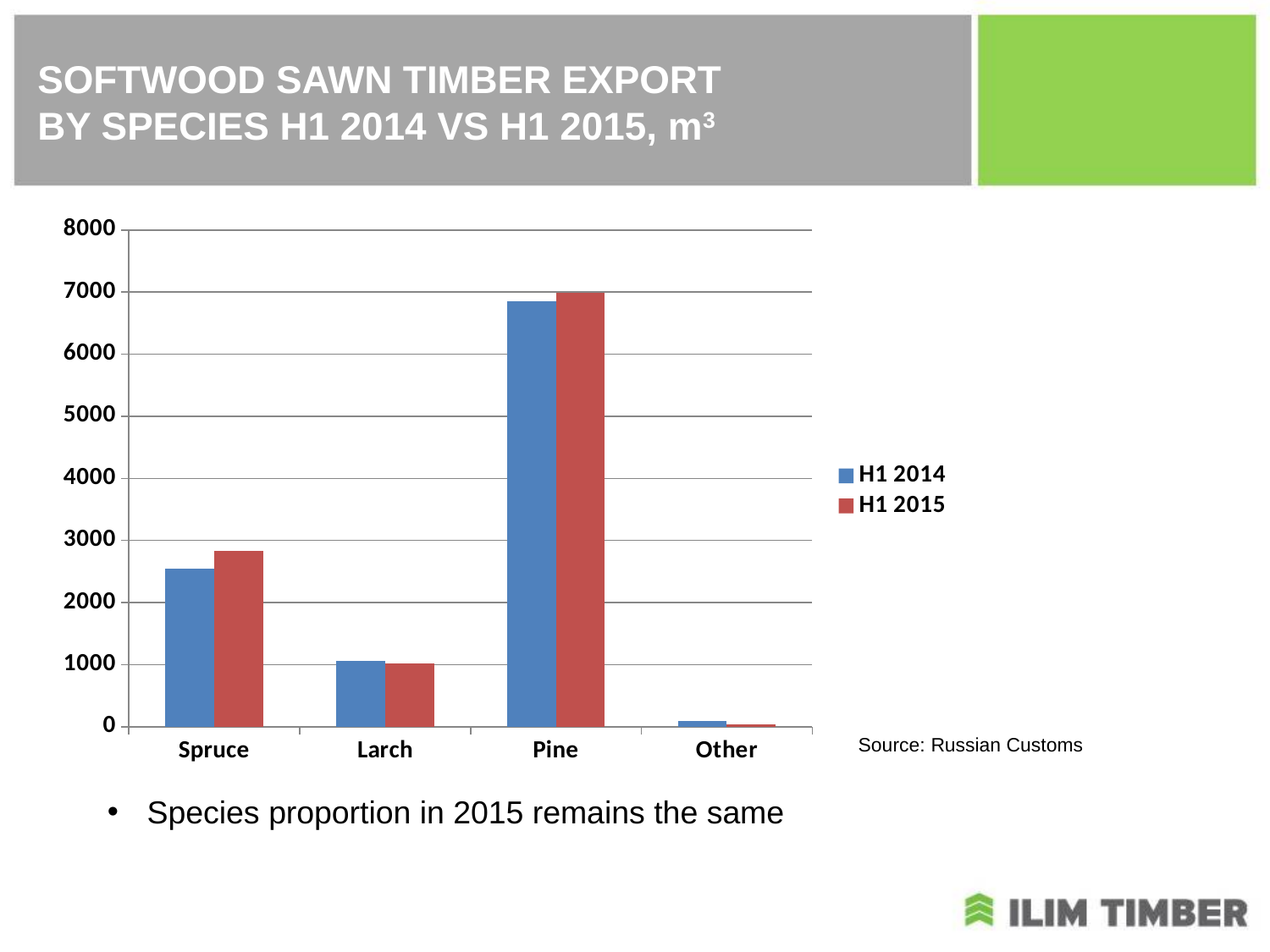
Which species has the lowest export volume in H1 2014? Other Which species has the second-highest export volume in H1 2014? Spruce Is the H1 2014 value for Pine greater or less than 7000? less How many species categories are shown on the x axis? 4 What is the source cited for the chart data? Russian Customs For Spruce, which is larger: the H1 2014 value or the H1 2015 value? H1 2015 Which species has the highest export volume in H1 2015? Pine Is the H1 2014 value for Spruce greater or less than 2000? greater Is the H1 2015 value for Other greater or less than 1000? less What kind of chart is shown on the slide? bar chart What are the two series named in the legend? H1 2014 and H1 2015 How many series does the legend list? 2